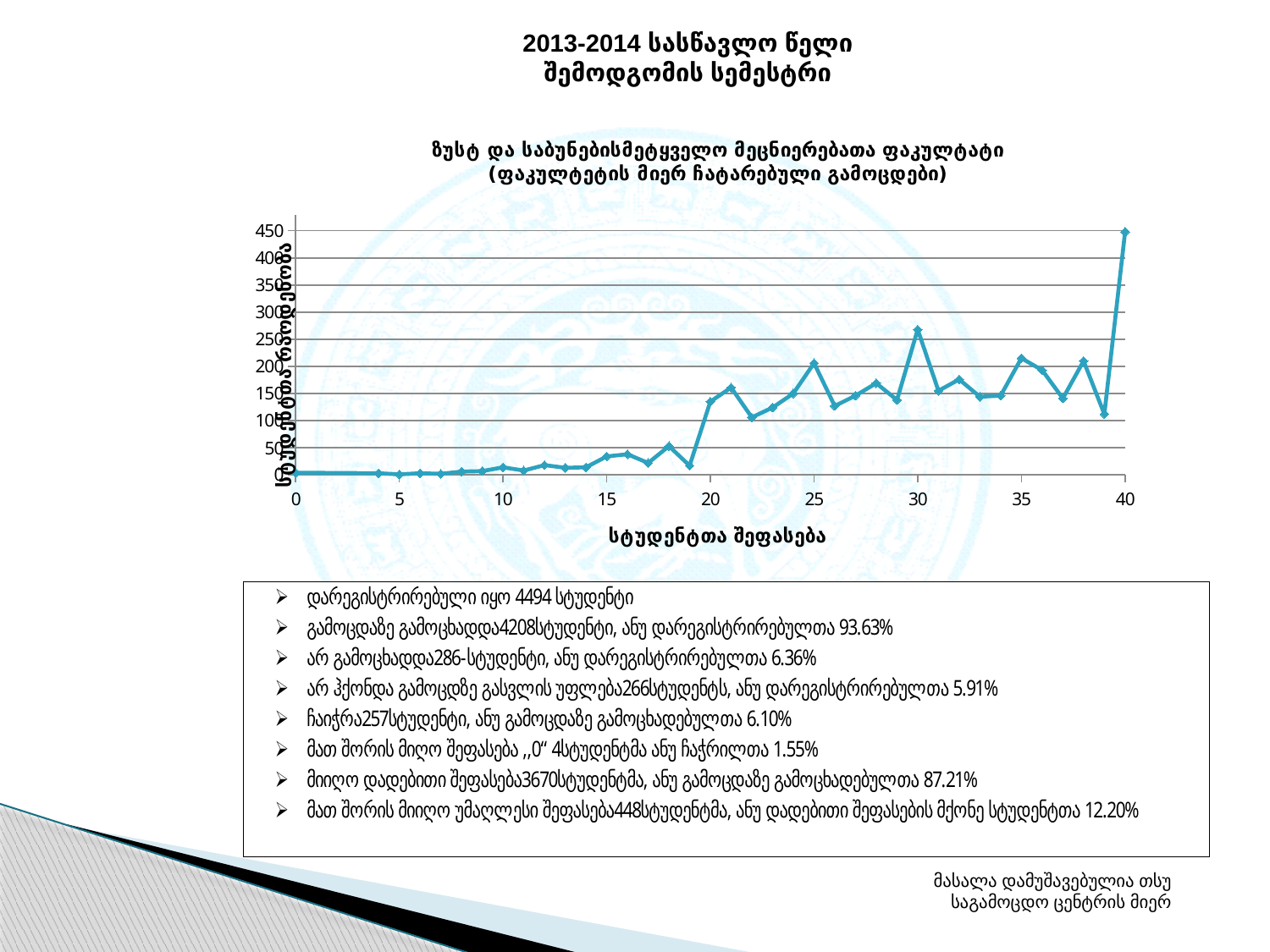
What kind of chart is shown on the slide? line chart Is the value at x = 40 greater or less than 400? greater Is the value at x = 25 greater or less than 150? greater At which x-axis value (student assessment score) does the line reach its highest point? 40 Which has the larger value, x = 15 or x = 25? 25 What is the label of the x-axis? სტუდენტთა შეფასება Is the value at x = 30 greater or less than 200? greater Which has the larger value, x = 20 or x = 30? 30 What is the highest tick value shown on the y-axis? 450 Overall, do the values rise or fall as the x-axis value increases from 0 to 40? rise